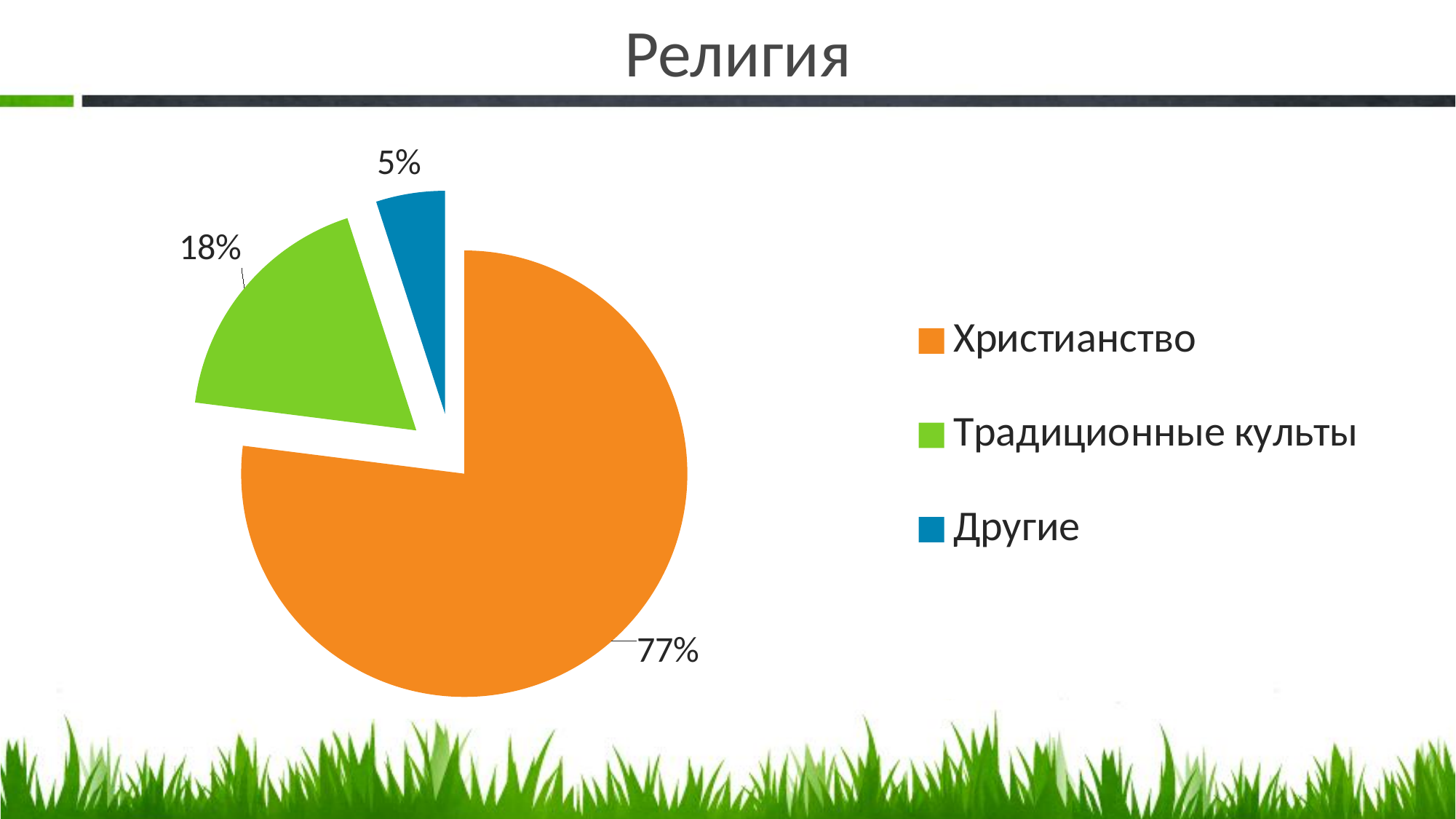
How many categories does the pie chart show? 3 What share of the pie does Традиционные культы have? 18% What is the title of the slide? Религия Which category has the largest slice of the pie? Христианство Which category has the smallest slice of the pie? Другие What share of the pie does Другие have? 5% What colour is the slice for Другие? blue What is the difference in percentage points between Традиционные культы and Другие? 13 What is the difference in percentage points between Христианство and Традиционные культы? 59 What kind of chart is shown on the slide? pie chart What share of the pie does Христианство have? 77% Which is larger, the share for Традиционные культы or the share for Другие? Традиционные культы